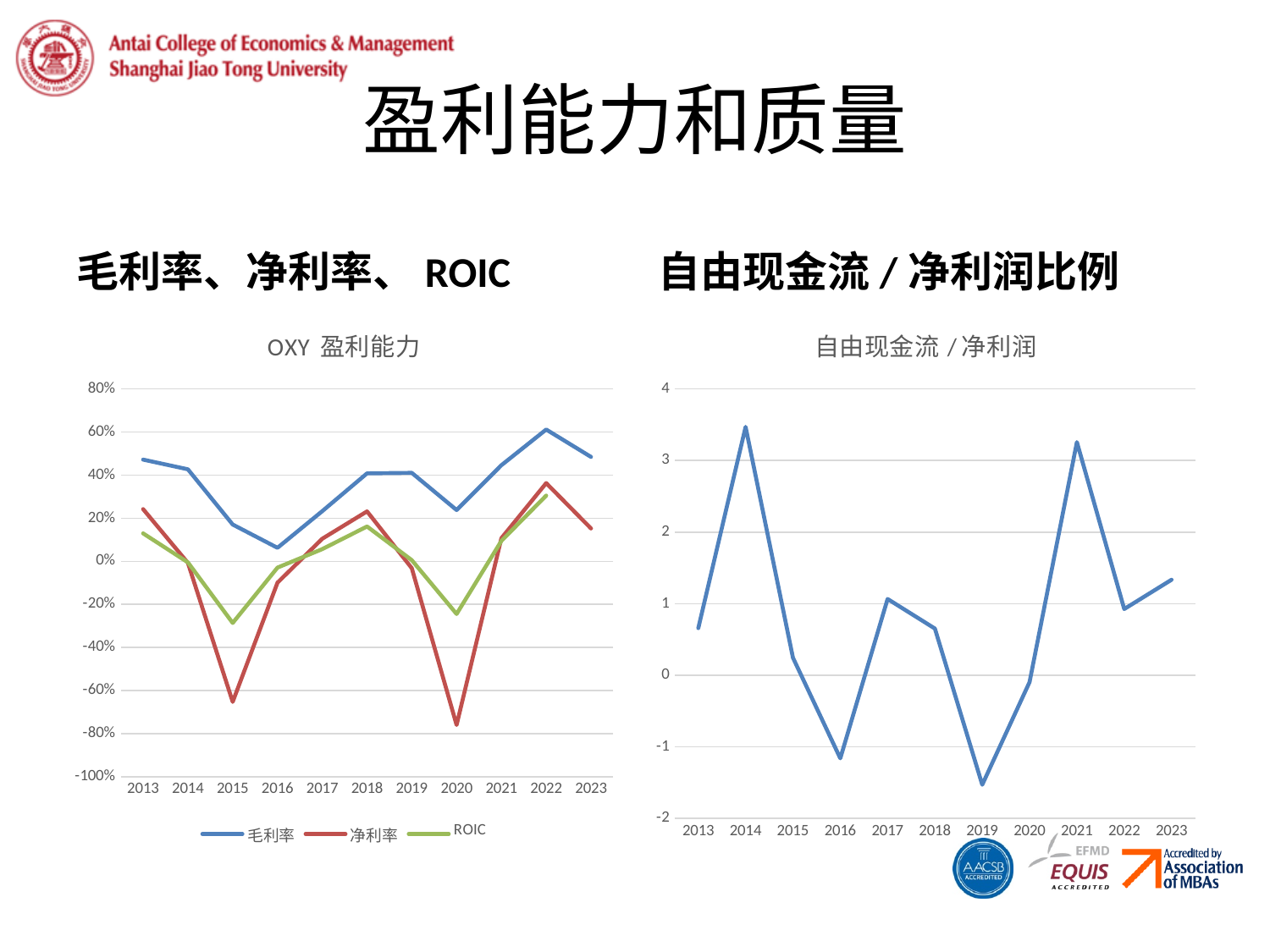
In the left chart "OXY 盈利能力", is the value of 毛利率 for 2013 greater or less than 40%? greater How many years are shown on the x axis of the right chart "自由现金流 / 净利润"? 11 How many series does the legend of the left chart "OXY 盈利能力" list? 3 What kind of chart is the left chart titled "OXY 盈利能力"? line chart In the right chart "自由现金流 / 净利润", in which year is the value lowest? 2019 In the right chart "自由现金流 / 净利润", is the value for 2019 greater or less than -1? less In the left chart "OXY 盈利能力", in which year is 毛利率 highest? 2022 In the right chart "自由现金流 / 净利润", in which year is the value highest? 2014 In the left chart "OXY 盈利能力", is the value of 净利率 for 2020 greater or less than -60%? less In the left chart "OXY 盈利能力", which is larger in 2015, 毛利率 or 净利率? 毛利率 In the right chart "自由现金流 / 净利润", which year has the larger value, 2016 or 2017? 2017 In the left chart "OXY 盈利能力", in which year is 净利率 lowest? 2020